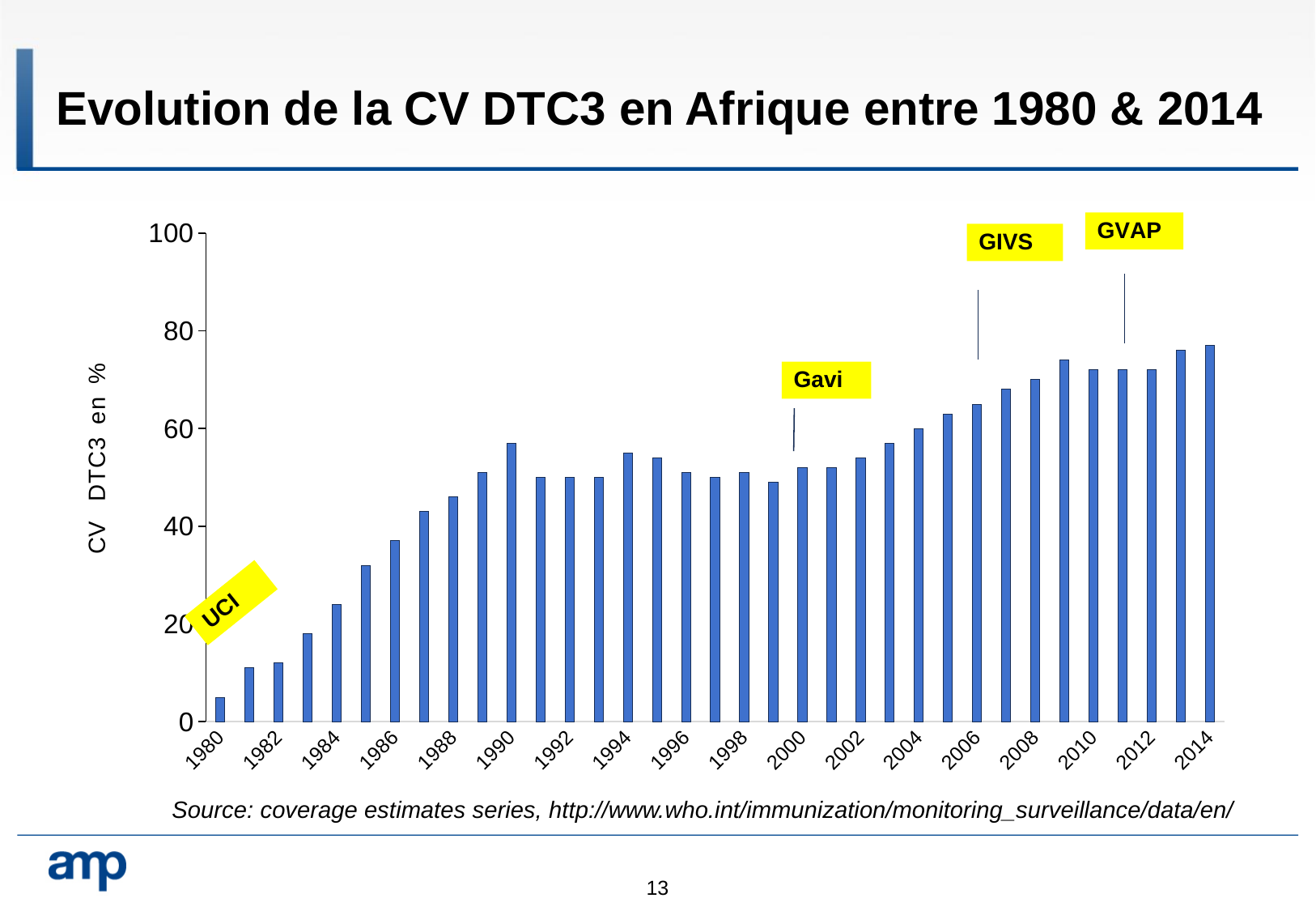
Is the value for 1980 greater or less than 20? less Is the value for 2006 greater or less than 60? greater What kind of chart is shown on the slide? bar chart Is the value for 1990 greater or less than 60? less Overall, do the values rise or fall from 1980 to 2014? rise How many years (bars) are plotted in the chart? 35 What is the label of the vertical axis? CV DTC3 en % Which year has the lowest DTC3 coverage value? 1980